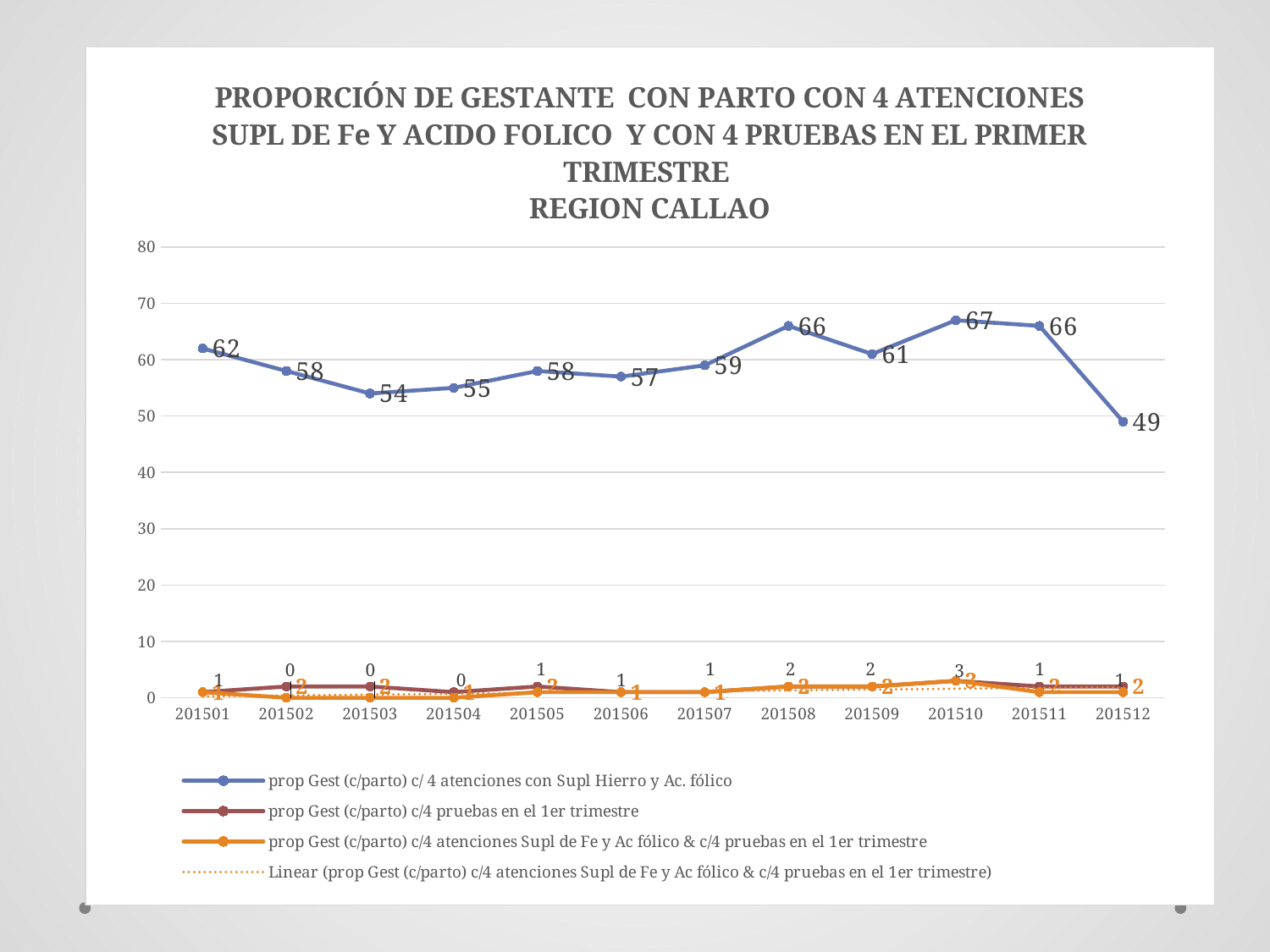
What is the value of the series 'prop Gest (c/parto) c/4 pruebas en el 1er trimestre' for 201510? 3 How many entries does the chart legend list? 4 What is the value of the series 'prop Gest (c/parto) c/ 4 atenciones con Supl Hierro y Ac. fólico' for 201508? 66 What is the value of the series 'prop Gest (c/parto) c/ 4 atenciones con Supl Hierro y Ac. fólico' for 201501? 62 What type of chart is shown on the slide? line chart What is the difference between the values of the series 'prop Gest (c/parto) c/ 4 atenciones con Supl Hierro y Ac. fólico' for 201510 and 201512? 18 What is the value of the series 'prop Gest (c/parto) c/ 4 atenciones con Supl Hierro y Ac. fólico' for 201512? 49 In which period does the series 'prop Gest (c/parto) c/ 4 atenciones con Supl Hierro y Ac. fólico' reach its lowest value? 201512 For the series 'prop Gest (c/parto) c/ 4 atenciones con Supl Hierro y Ac. fólico', which period has the larger value, 201503 or 201509? 201509 How many periods are shown on the x axis of the chart? 12 In which period does the series 'prop Gest (c/parto) c/ 4 atenciones con Supl Hierro y Ac. fólico' reach its highest value? 201510 Is the value of the series 'prop Gest (c/parto) c/ 4 atenciones con Supl Hierro y Ac. fólico' for 201511 greater or less than 60? greater